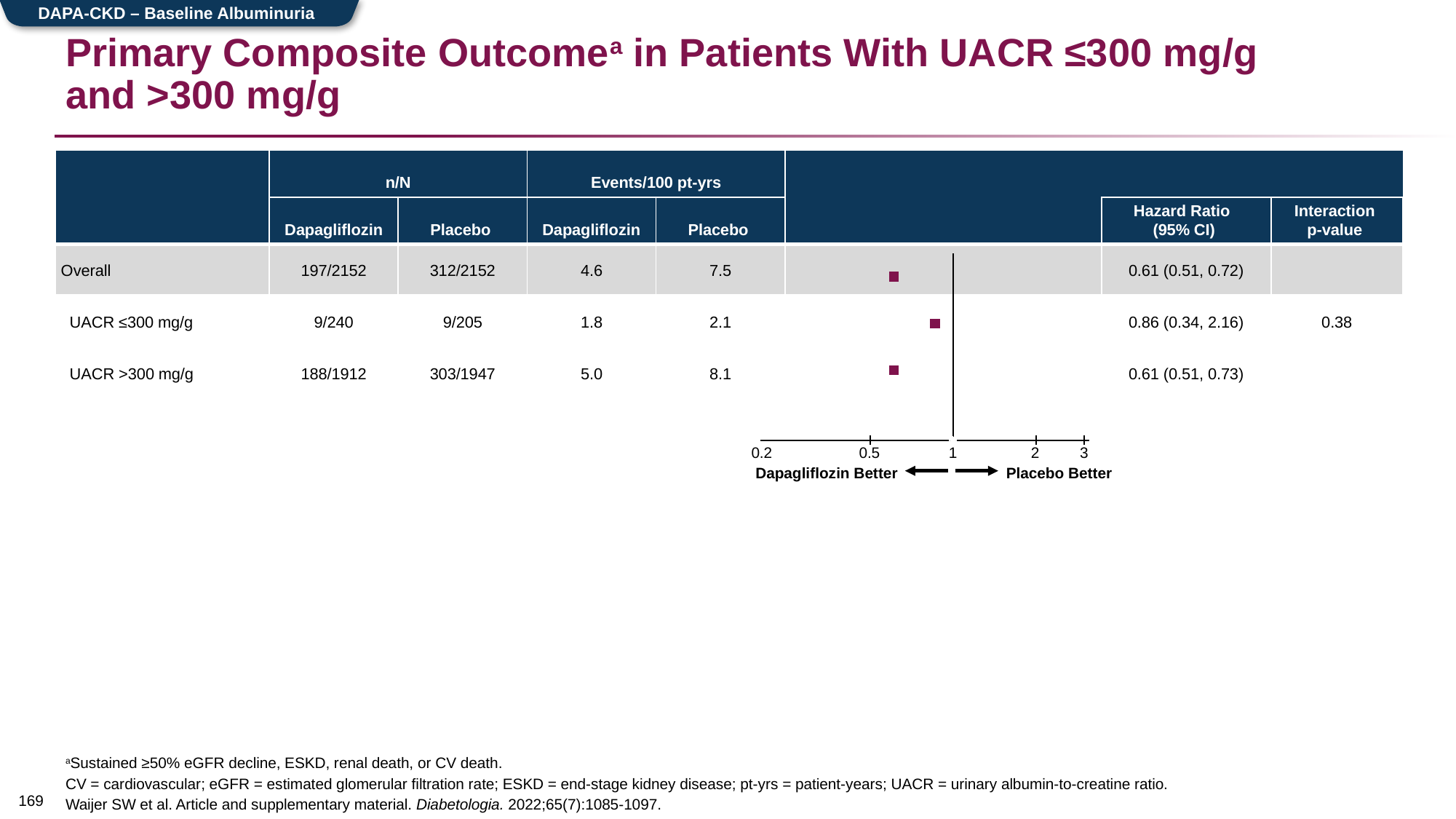
What is the hazard ratio (95% CI) for the Overall group? 0.61 (0.51, 0.72) Which has the larger hazard ratio, UACR ≤300 mg/g or UACR >300 mg/g? UACR ≤300 mg/g Which subgroup has the highest hazard ratio? UACR ≤300 mg/g What is the hazard ratio (95% CI) for patients with UACR >300 mg/g? 0.61 (0.51, 0.73) What kind of chart is shown on the slide? forest plot How many subgroup points are plotted in the forest plot? 3 What is the hazard ratio (95% CI) for patients with UACR ≤300 mg/g? 0.86 (0.34, 2.16) Is the hazard ratio for the Overall group greater or less than 0.5? greater Is the hazard ratio for UACR ≤300 mg/g greater or less than 1? less What is the interaction p-value shown for the UACR subgroups? 0.38 Which side of the forest plot is labelled 'Dapagliflozin Better'? the left side What is the difference between the hazard ratio for UACR ≤300 mg/g and the hazard ratio for UACR >300 mg/g? 0.25